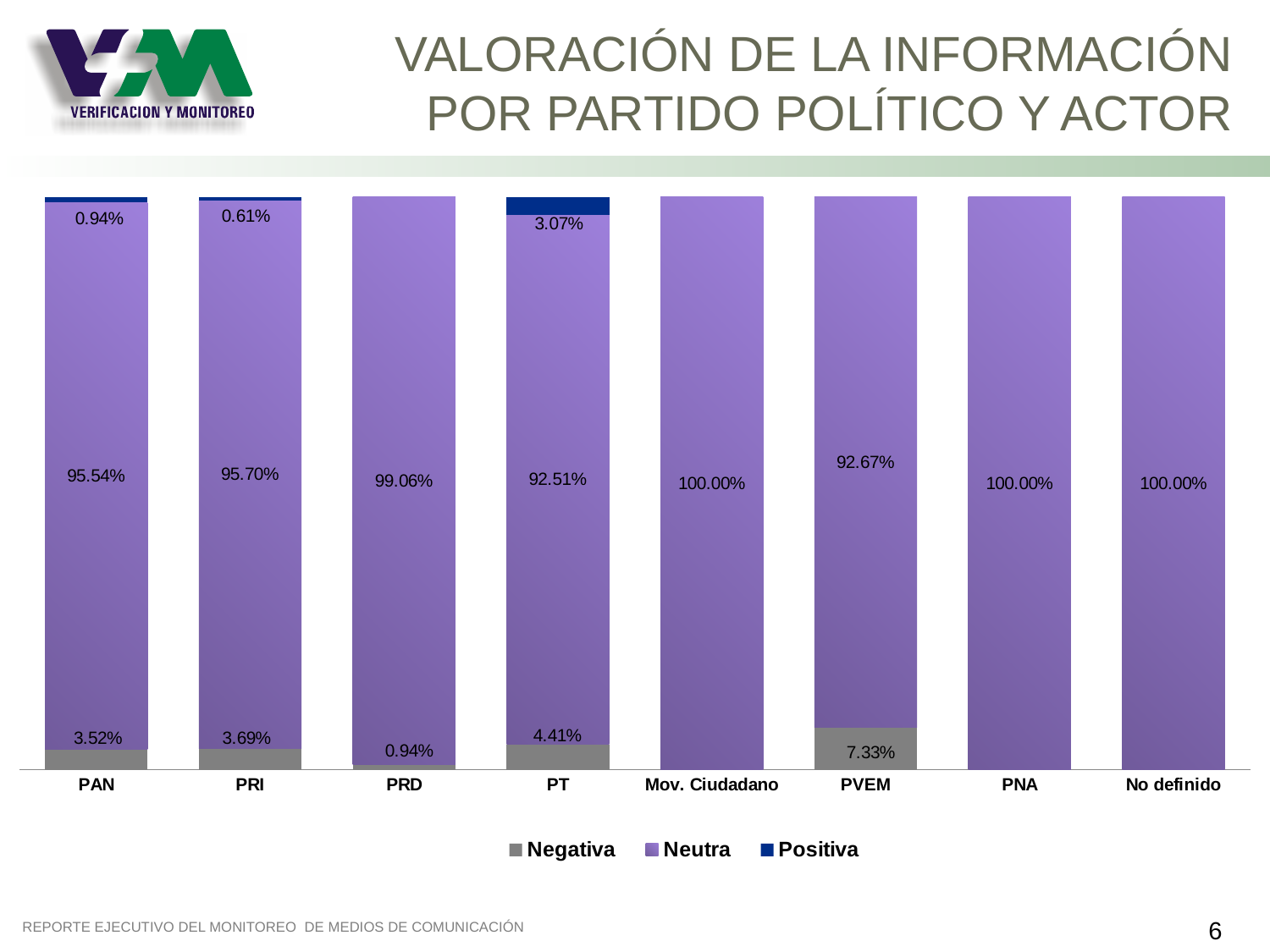
What is the Negativa value for PVEM? 7.33% What is the Neutra value for PAN? 95.54% What is the difference between the Negativa values for PVEM and PT? 2.92% How many parties or categories are shown on the x axis? 8 Which series is shown in grey in the legend? Negativa What is the Negativa value for PRD? 0.94% Which party has the highest Negativa value? PVEM Which is larger, the Neutra value for PRI or the Neutra value for PAN? PRI How many series does the legend list? 3 What kind of chart is shown on the slide? Stacked bar chart Which party has the highest Positiva value? PT What is the Positiva value for PT? 3.07%